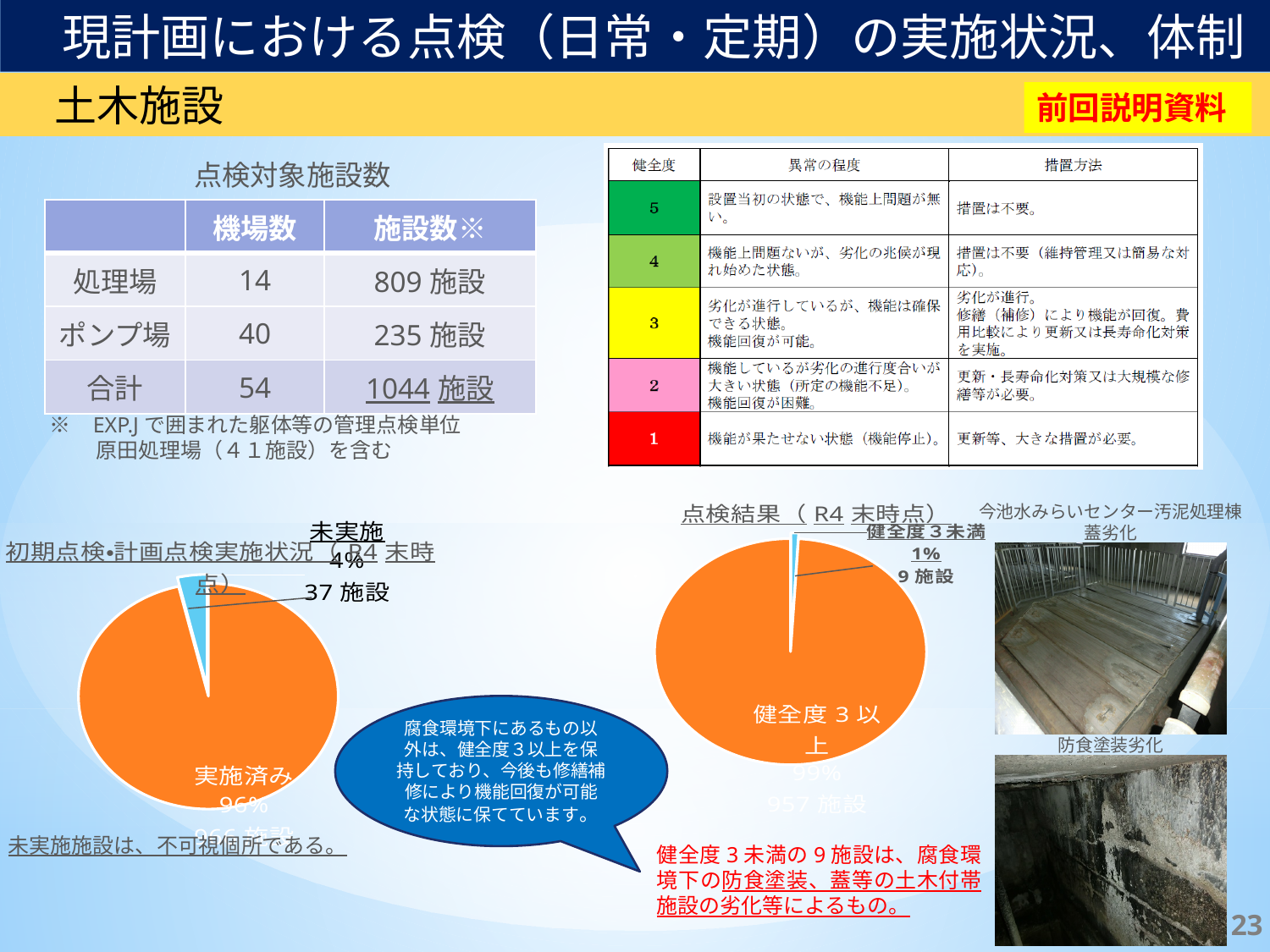
In the left pie chart (初期点検・計画点検実施状況), what percentage is shown for 未実施? 4% How many slices does the left pie chart (初期点検・計画点検実施状況) have? 2 In the left pie chart (初期点検・計画点検実施状況), how many facilities are labelled as 未実施? 37 施設 In the right pie chart titled 点検結果（R4末時点）, what is the difference in facility count between 健全度3以上 and 健全度3未満? 948 施設 What kind of chart is the left chart titled 初期点検・計画点検実施状況（R4末時点）? pie chart In the left pie chart (初期点検・計画点検実施状況), which slice is larger, 実施済み or 未実施? 実施済み In the right pie chart titled 点検結果（R4末時点）, what percentage is shown for 健全度3未満? 1% In the left pie chart (初期点検・計画点検実施状況), what percentage is shown for 実施済み? 96% In the right pie chart titled 点検結果（R4末時点）, how many facilities are labelled as 健全度3未満? 9 施設 In the right pie chart titled 点検結果（R4末時点）, which slice is the smallest? 健全度3未満 In the right pie chart titled 点検結果（R4末時点）, how many facilities are labelled as 健全度3以上? 957 施設 In the right pie chart titled 点検結果（R4末時点）, what percentage is shown for 健全度3以上? 99%